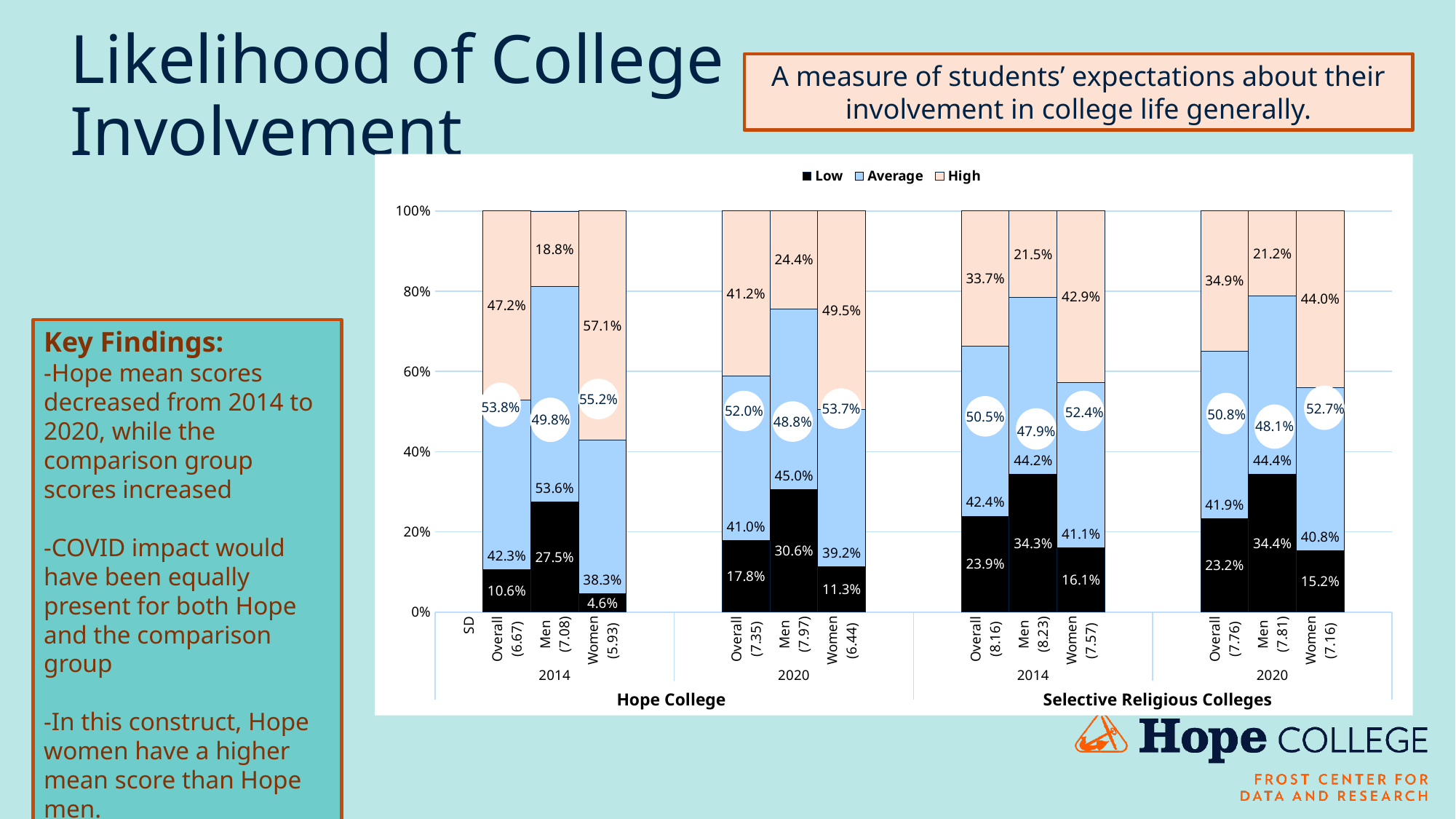
Which bar has the lowest High percentage across all groups? Hope College Men 2014 What is the Average percentage for Selective Religious Colleges Overall in 2014? 42.4% What is the High percentage for Hope College Men in 2020? 24.4% Which is larger: the Low percentage for Hope College Overall in 2014 or in 2020? 2020 What kind of chart is shown on the slide? stacked bar chart What is the difference between the High percentage for Hope College Women in 2014 and Hope College Women in 2020? 7.6% Which colour represents the High series in the chart? light orange/peach Which bar has the highest Low percentage across all groups? Selective Religious Colleges Men 2020 How many series does the chart legend list? 3 How many stacked bars are plotted in the chart? 12 What is the Low percentage for Selective Religious Colleges Men in 2020? 34.4% What is the Low percentage for Hope College Women in 2014? 4.6%